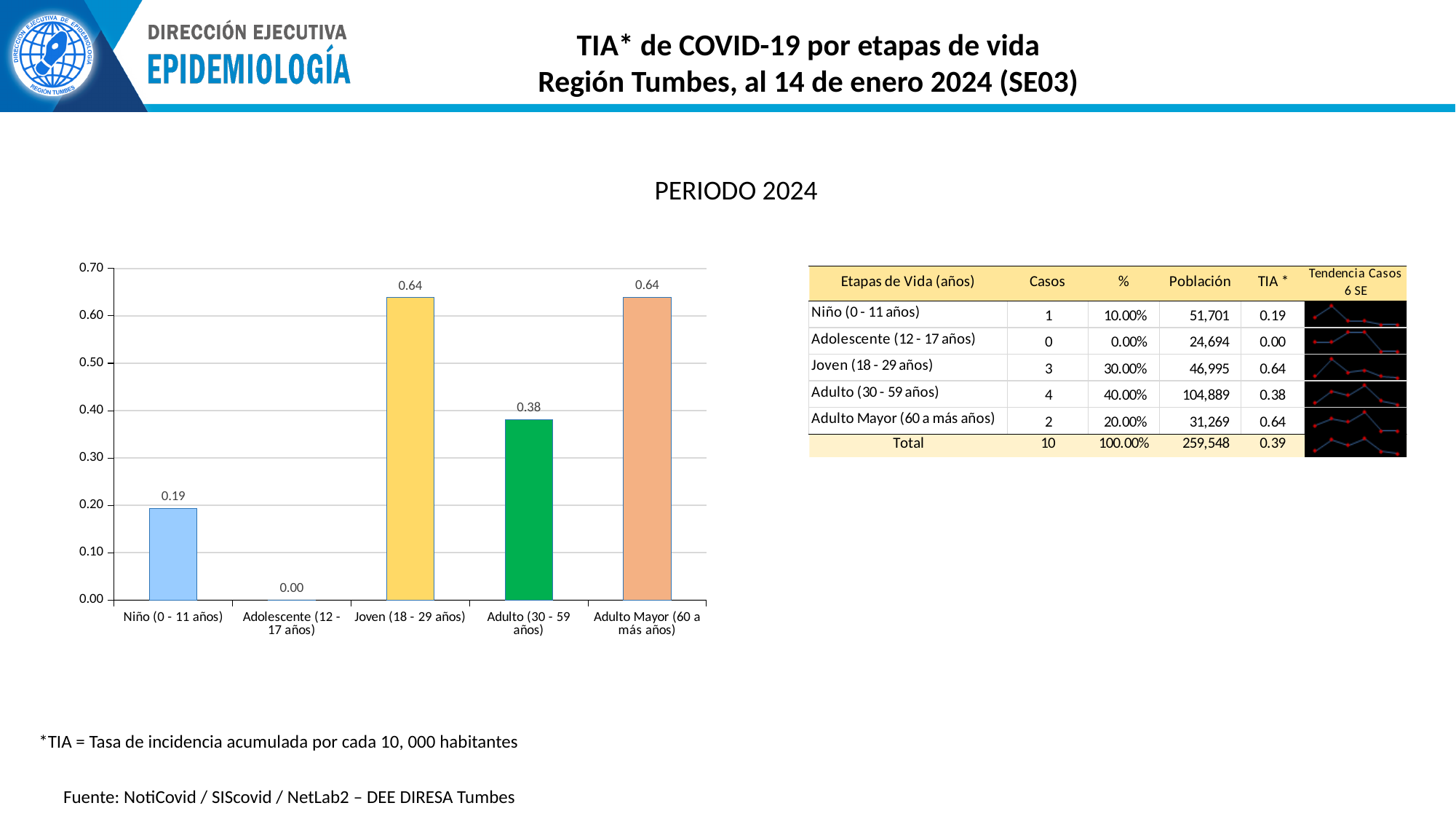
Which age group has the lowest value in the bar chart? Adolescente (12 - 17 años) Is the value for Adulto (30 - 59 años) in the bar chart greater or less than 0.40? less What is the difference between the values for Joven (18 - 29 años) and Adulto (30 - 59 años) in the bar chart? 0.26 How many age-group categories are shown in the bar chart? 5 Which is larger in the bar chart, the value for Adulto Mayor (60 a más años) or the value for Adulto (30 - 59 años)? Adulto Mayor (60 a más años) What kind of chart is used to show the TIA by age group? bar chart What is the TIA value for Niño (0 - 11 años) in the bar chart? 0.19 What is the TIA value for Joven (18 - 29 años) in the bar chart? 0.64 What is the difference between the values for Adulto (30 - 59 años) and Niño (0 - 11 años) in the bar chart? 0.19 What is the TIA value for Adolescente (12 - 17 años) in the bar chart? 0.00 What is the title shown above the bar chart? PERIODO 2024 What is the TIA value for Adulto (30 - 59 años) in the bar chart? 0.38